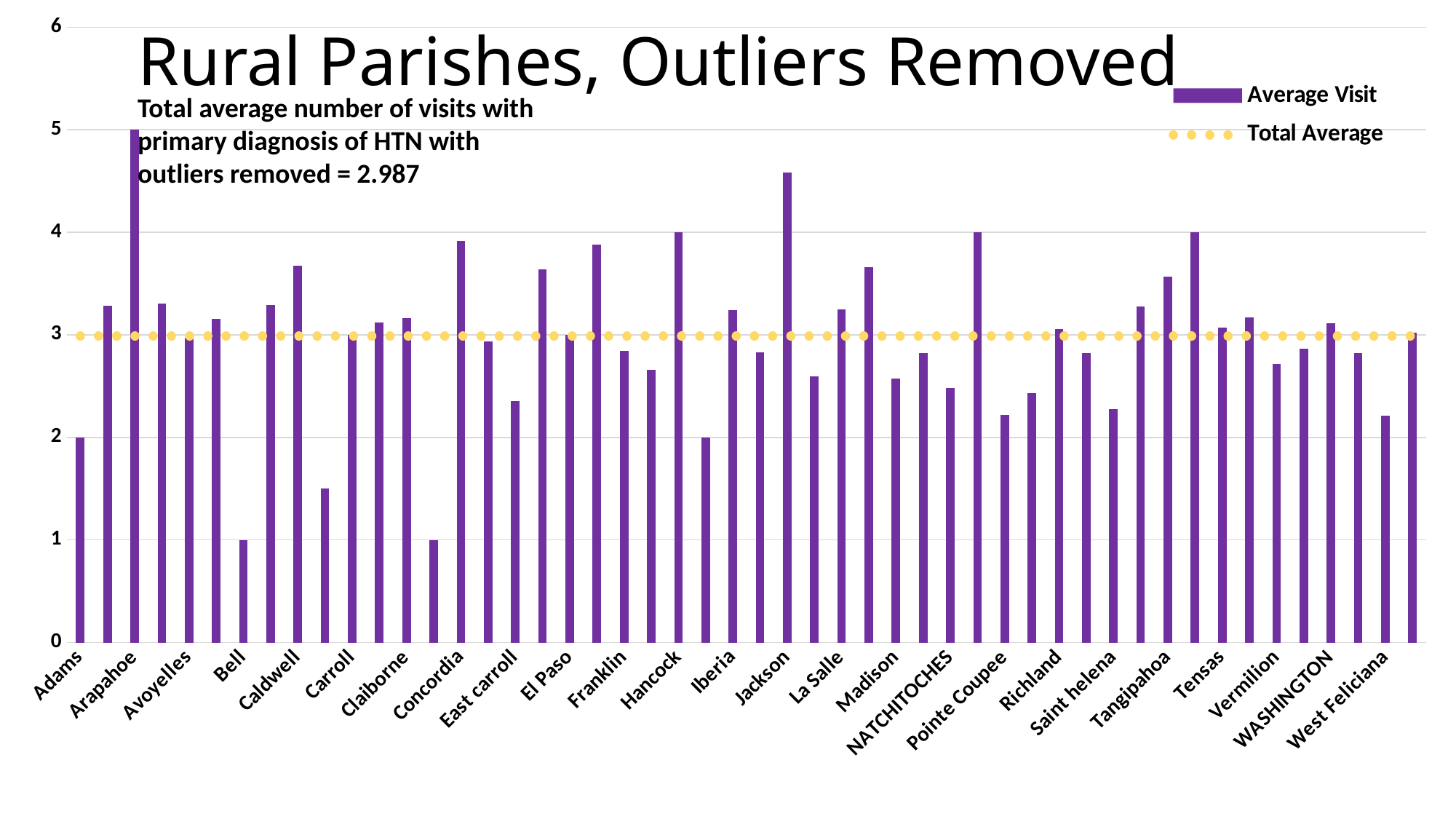
What kind of chart is shown on the slide? combination bar and line chart What are the two entries in the chart legend? Average Visit and Total Average How many series does the legend list? 2 What is the Average Visit value for Bell? 1 What is the Average Visit value for Adams? 2 Which has the larger Average Visit value, Hancock or Madison? Hancock Is the Average Visit value for Caldwell greater or less than 3? greater Which has the larger Average Visit value, Concordia or East carroll? Concordia Is the Average Visit value for Jackson greater or less than 4? greater Which labelled parish has the highest Average Visit value? Arapahoe What is the total average number of visits with outliers removed, as stated on the slide? 2.987 Is the Average Visit value for Pointe Coupee greater or less than 3? less